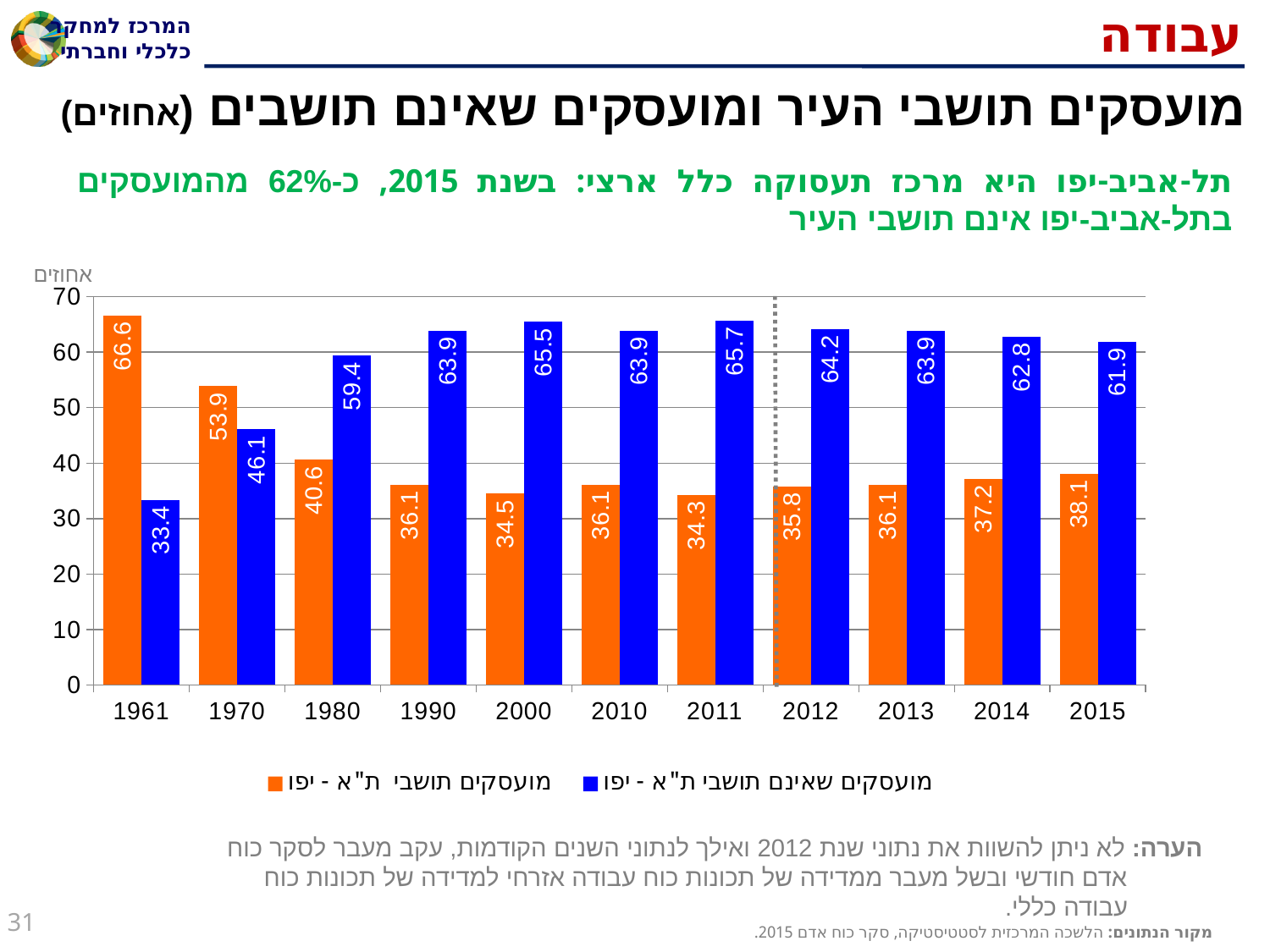
How many years are shown on the x axis? 11 In which year is the orange series (מועסקים תושבי ת"א - יפו) highest? 1961 What is the value of the blue series (מועסקים שאינם תושבי ת"א - יפו) for 2015? 61.9 What is the total of the orange and blue values for 2012? 100 What kind of chart is shown on the slide? bar chart In which year is the blue series (מועסקים שאינם תושבי ת"א - יפו) lowest? 1961 What is the value of the blue series (מועסקים שאינם תושבי ת"א - יפו) for 2000? 65.5 What is the value of the orange series (מועסקים תושבי ת"א - יפו) for 1961? 66.6 Does the orange series (מועסקים תושבי ת"א - יפו) rise or fall from 1961 to 1990? fall What is the difference between the blue and orange values in 2015? 23.8 How many series does the legend list? 2 In 1970, which series has the larger value, the orange (residents) or the blue (non-residents)? orange (מועסקים תושבי ת"א - יפו)